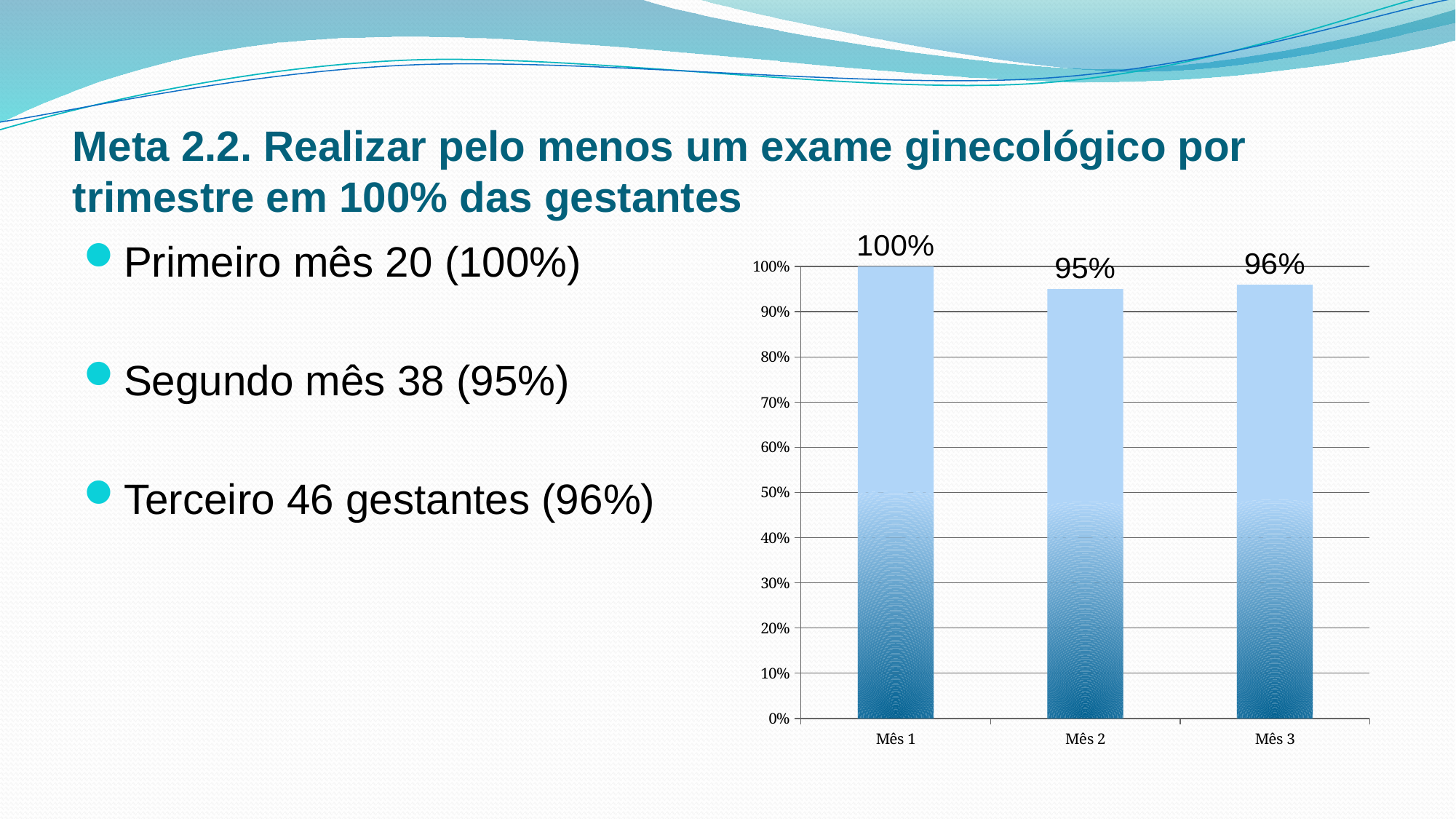
Which month has the lowest value? Mês 2 What is the difference between the values for Mês 1 and Mês 2? 5% What is the value for Mês 2? 95% Is the value for Mês 2 greater or less than 90%? greater What is the highest tick value shown on the y axis? 100% What kind of chart is shown on the slide? bar chart What is the value for Mês 1? 100% How many categories are shown on the x axis? 3 Which month has the highest value? Mês 1 What is the difference between the values for Mês 3 and Mês 2? 1% What is the value for Mês 3? 96% Which is larger, the value for Mês 1 or the value for Mês 3? Mês 1